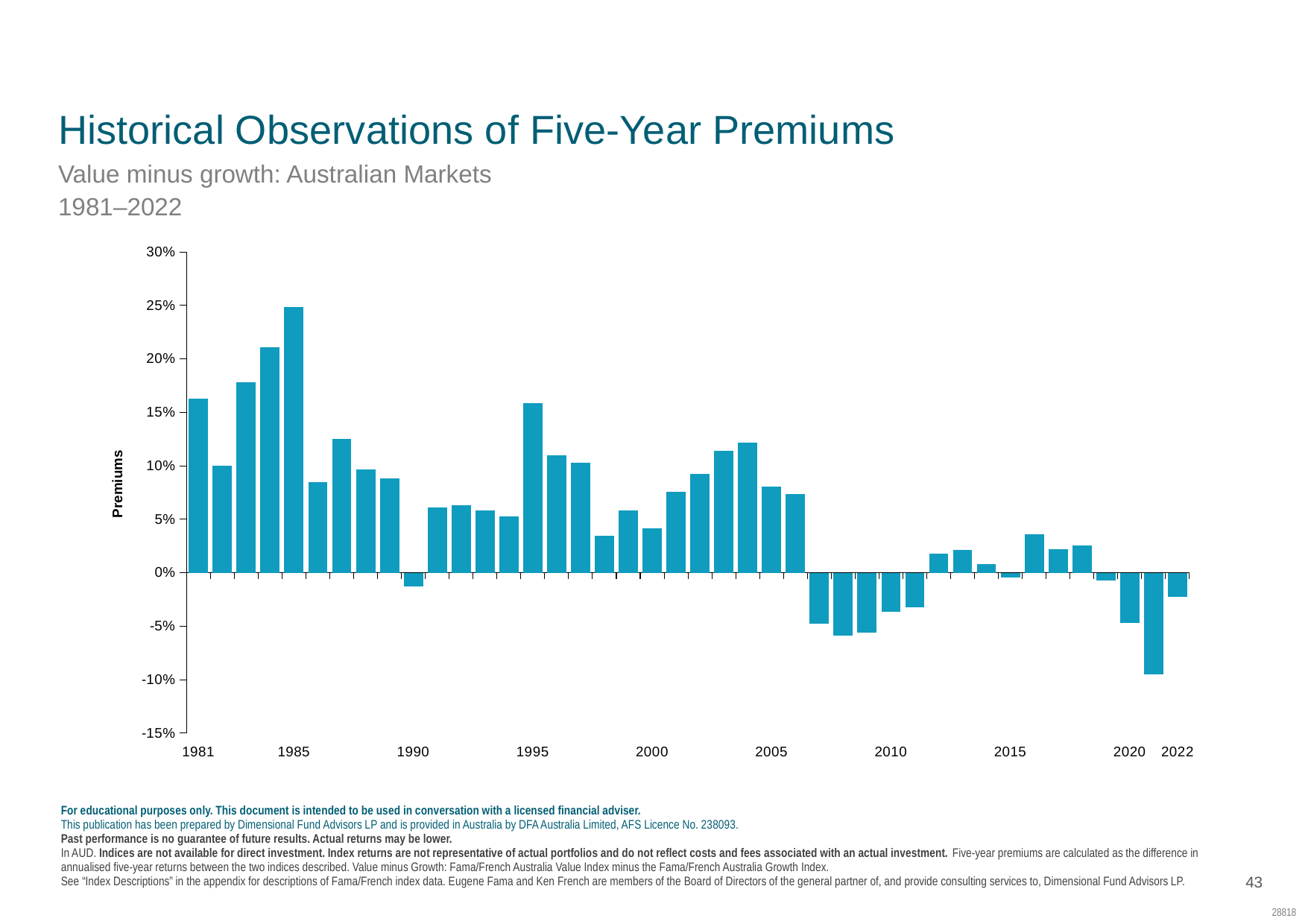
How many years are plotted in the chart? 42 What type of chart is shown on the slide? Bar chart What is the label on the vertical axis? Premiums Is the value for 1985 greater or less than 20%? greater Is the value for 1990 greater or less than 0%? less Which year has the highest five-year premium? 1985 Is the value for 2010 greater or less than 0%? less Which year has the larger premium, 1981 or 1982? 1981 Which year has the lowest five-year premium? 2021 Which year has the larger premium, 1995 or 2000? 1995